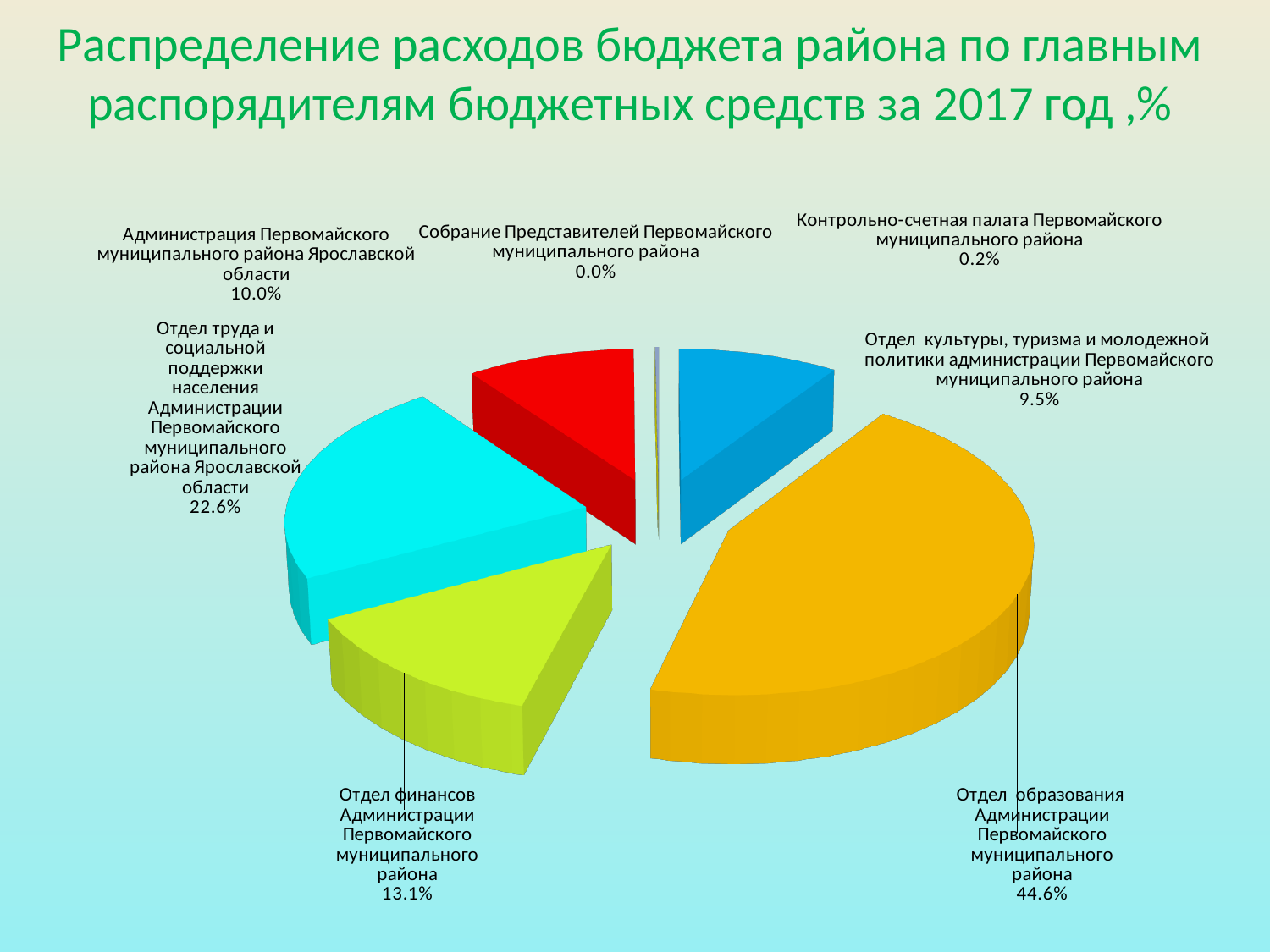
Which category has the smallest share of the district budget expenditures? Собрание Представителей Первомайского муниципального района What is the difference in percentage points between the share of Отдел финансов and the share of Администрация Первомайского муниципального района Ярославской области? 3.1 What share of expenditures goes to Отдел образования Администрации Первомайского муниципального района? 44.6% How many categories (slices) does the pie chart show? 7 What is the difference in percentage points between the share of Отдел образования and the share of Отдел труда и социальной поддержки населения? 22.0 What share of expenditures goes to Контрольно-счетная палата Первомайского муниципального района? 0.2% What share of expenditures goes to Отдел финансов Администрации Первомайского муниципального района? 13.1% Which has a larger share: Администрация Первомайского муниципального района Ярославской области or Отдел культуры, туризма и молодежной политики? Администрация Первомайского муниципального района Ярославской области For which year does the chart show the distribution of district budget expenditures? 2017 Which category has the largest share of the district budget expenditures? Отдел образования Администрации Первомайского муниципального района What kind of chart is shown on the slide? Pie chart What share of expenditures goes to Отдел труда и социальной поддержки населения? 22.6%